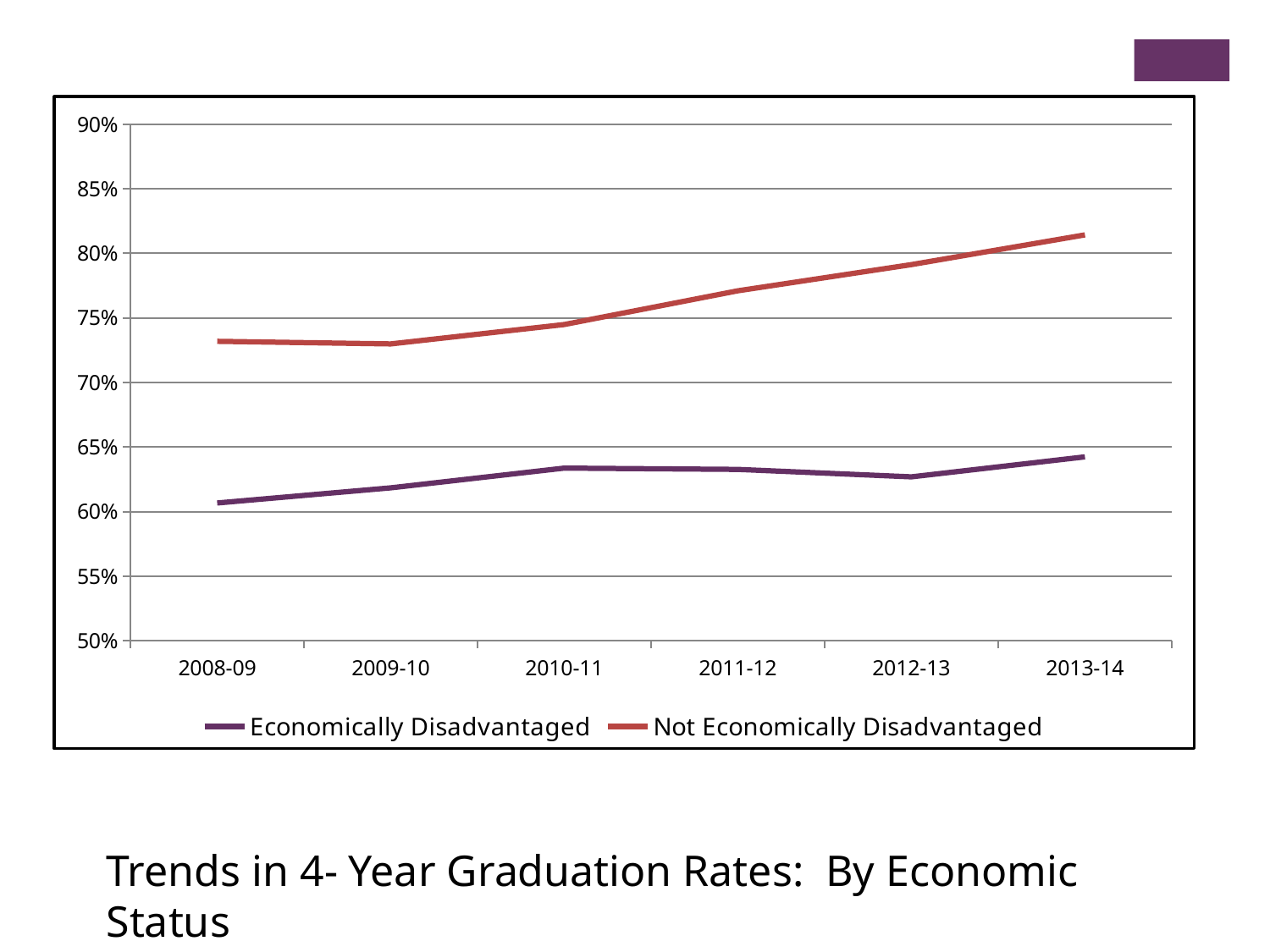
Is the value for Not Economically Disadvantaged in 2013-14 greater or less than 80%? greater How many school years are plotted along the x axis? 6 Is the value for Not Economically Disadvantaged in 2008-09 greater or less than 75%? less In which school year is the Not Economically Disadvantaged graduation rate highest? 2013-14 Which series has the higher value in 2013-14, Economically Disadvantaged or Not Economically Disadvantaged? Not Economically Disadvantaged What is the title of the slide describing the chart? Trends in 4- Year Graduation Rates: By Economic Status Is the value for Not Economically Disadvantaged in 2011-12 greater or less than 75%? greater In which school year is the Economically Disadvantaged graduation rate lowest? 2008-09 Does the Not Economically Disadvantaged line rise or fall from 2009-10 to 2013-14? Rise What kind of chart is shown on the slide? Line chart How many series does the legend list? 2